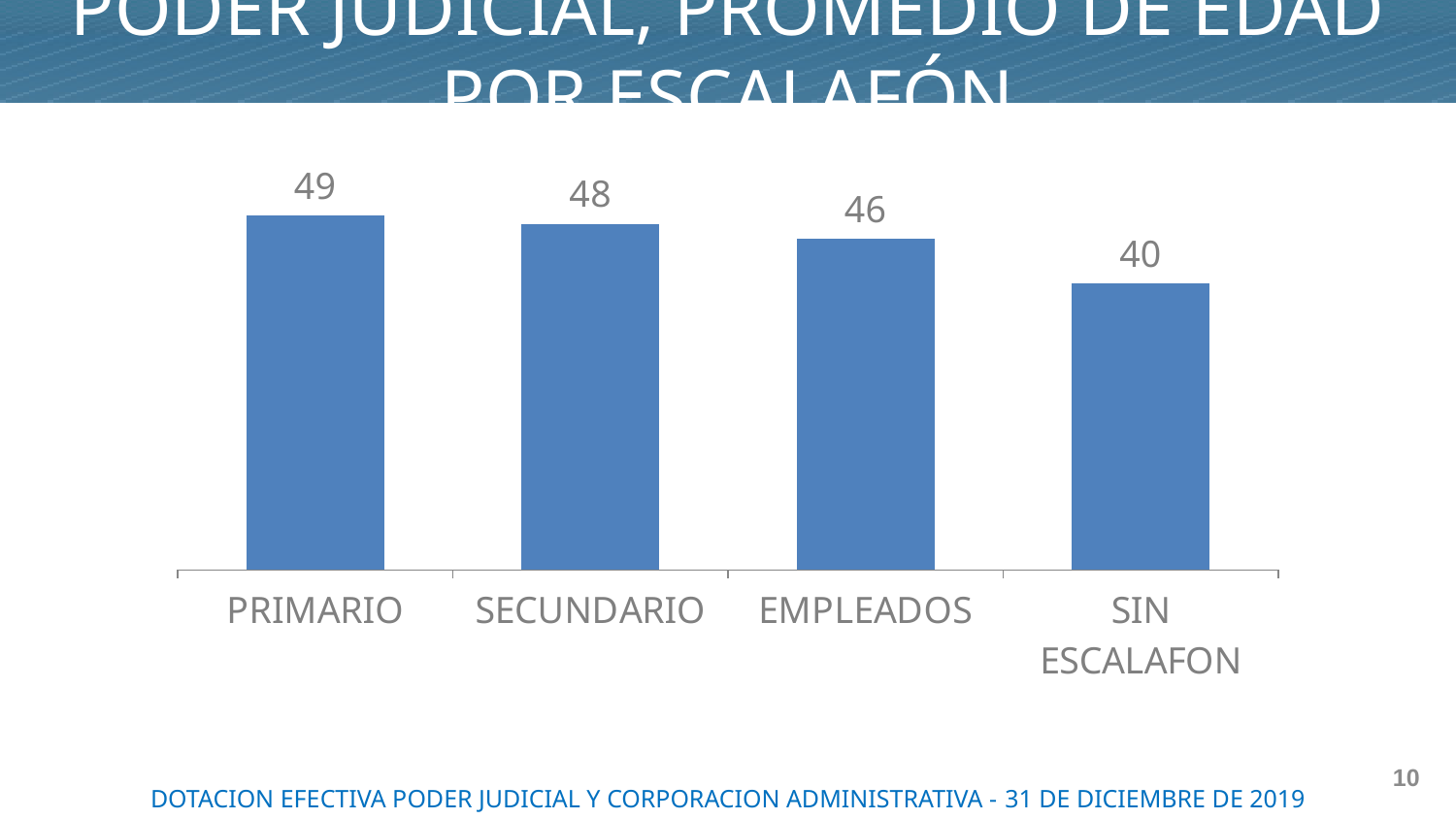
How many categories are shown in the chart? 4 What is the average age for PRIMARIO? 49 Which category has the highest average age? PRIMARIO Which category has the lowest average age? SIN ESCALAFON Do the values rise or fall from left to right across the categories? Fall What kind of chart is shown on the slide? Bar chart What is the average age for SIN ESCALAFON? 40 Which has a higher average age, EMPLEADOS or SIN ESCALAFON? EMPLEADOS What is the average age for EMPLEADOS? 46 What is the average age for SECUNDARIO? 48 What is the difference between the average age for PRIMARIO and SIN ESCALAFON? 9 What is the difference between the average age for SECUNDARIO and EMPLEADOS? 2